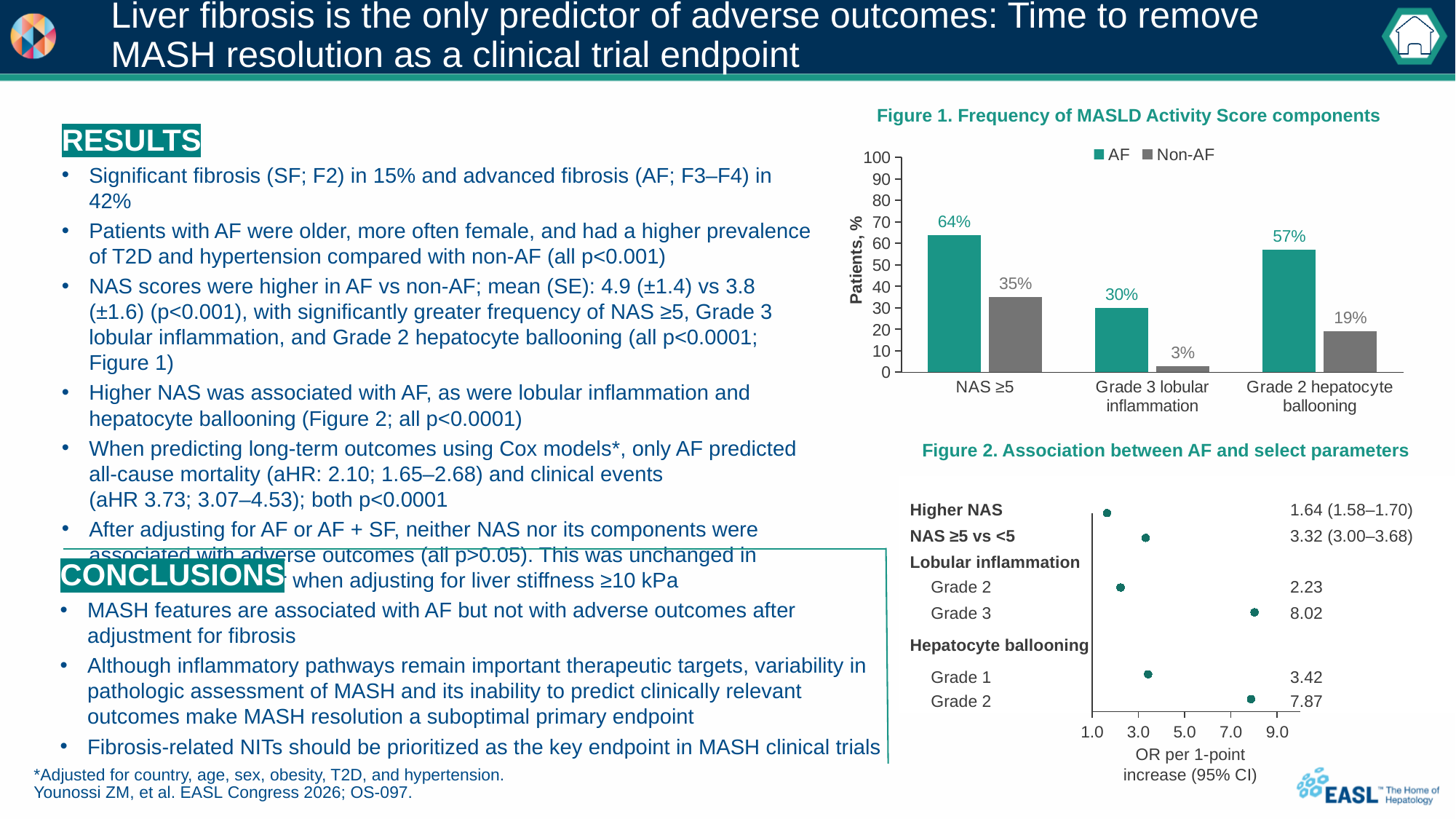
In Figure 1, what is the difference between AF and Non-AF for Grade 2 hepatocyte ballooning? 38% In Figure 1, what percentage of AF patients had NAS ≥5? 64% How many series does the legend in Figure 1 list? 2 In Figure 2, which parameter has the lowest OR? Higher NAS In Figure 1, what is the value for Non-AF patients with Grade 2 hepatocyte ballooning? 19% What kind of chart is Figure 1? Bar chart In Figure 1, which is larger: the AF value for Grade 3 lobular inflammation or the Non-AF value for NAS ≥5? Non-AF value for NAS ≥5 In Figure 2, what is the OR (95% CI) for NAS ≥5 vs <5? 3.32 (3.00–3.68) In Figure 1, which category has the lowest value for the Non-AF series? Grade 3 lobular inflammation In Figure 2, what is the OR for Grade 3 lobular inflammation? 8.02 In Figure 1, what percentage of Non-AF patients had Grade 3 lobular inflammation? 3% In Figure 1, which category has the highest value for the AF series? NAS ≥5